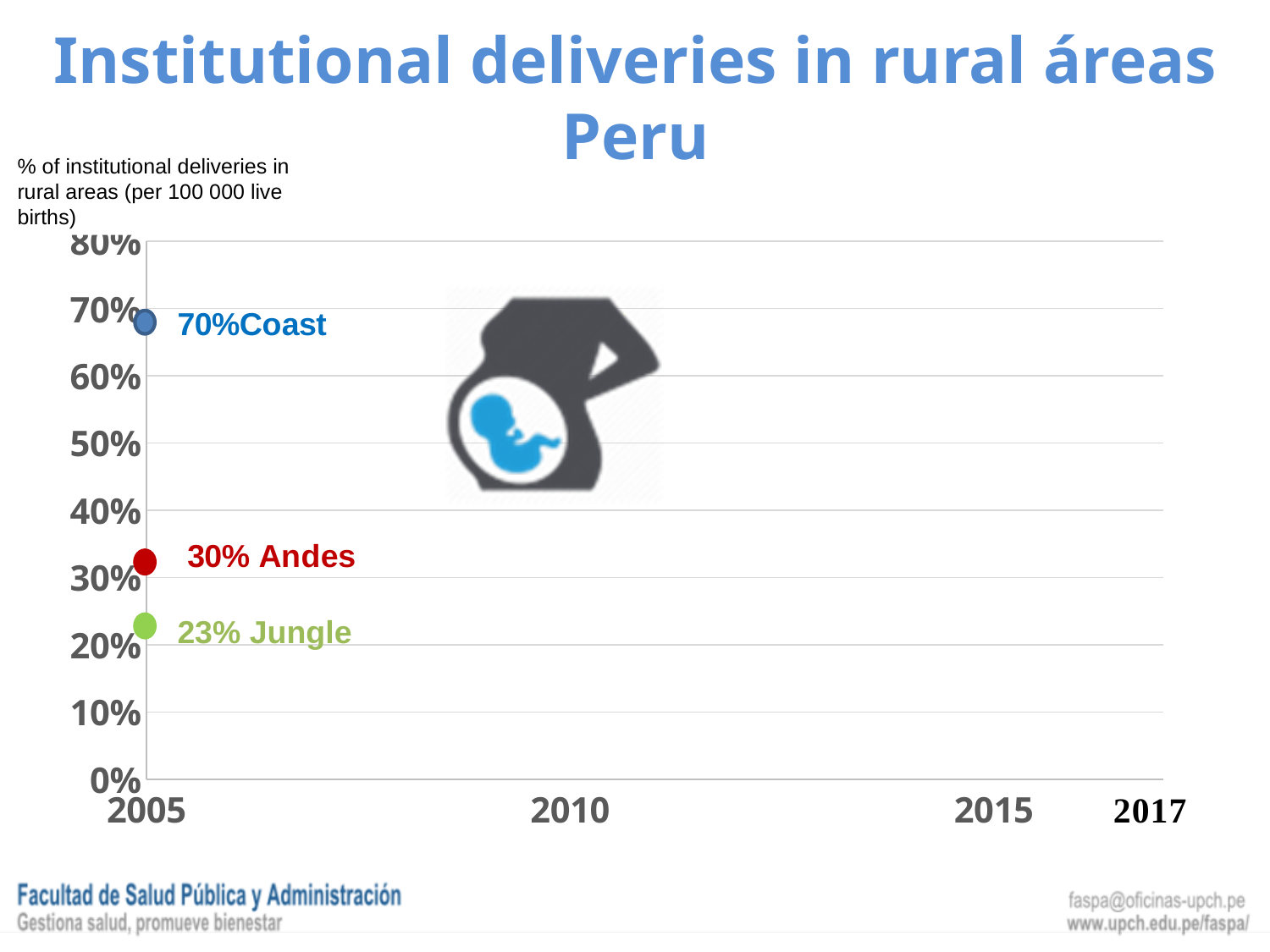
What is the difference between the Andes value and the Jungle value? 7% How many regions are plotted on the chart? 3 Which region has the highest percentage of institutional deliveries in rural areas? Coast What is the title of the slide containing the chart? Institutional deliveries in rural áreas Peru Which region has the lowest percentage of institutional deliveries in rural areas? Jungle Which is larger, the value for Andes or the value for Jungle? Andes What is the value for Jungle in 2005? 23% What is the value for Coast in 2005? 70% What is the value for Andes in 2005? 30% What is the difference between the Coast value and the Andes value? 40% Is the value for Coast greater or less than 60%? greater What is the first year shown on the x axis? 2005